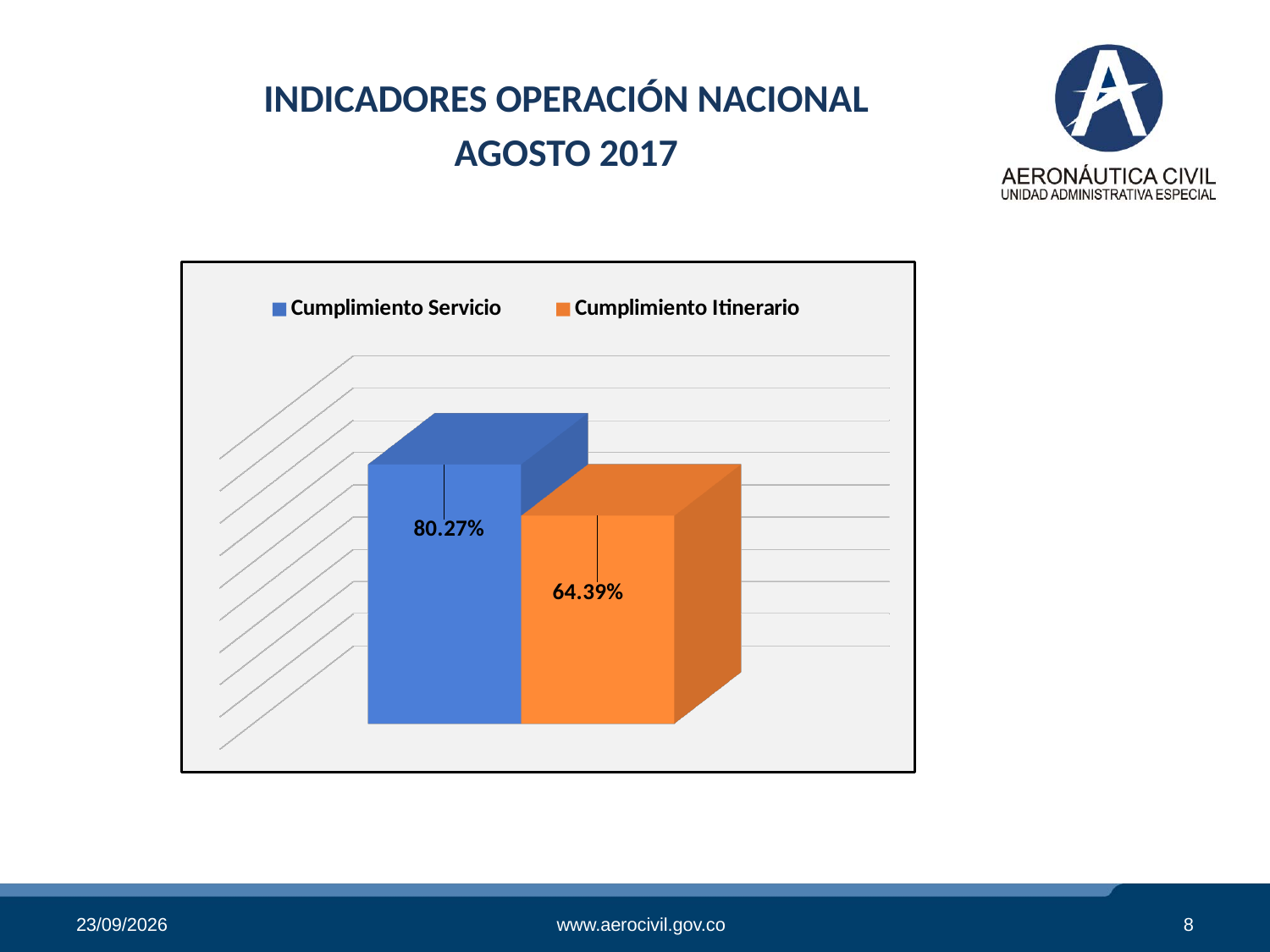
What is the difference between the Cumplimiento Servicio and Cumplimiento Itinerario values? 15.88% What is the value for Cumplimiento Servicio? 80.27% Which series has the higher value, Cumplimiento Servicio or Cumplimiento Itinerario? Cumplimiento Servicio Which series has the lowest value? Cumplimiento Itinerario How many series does the legend list? 2 How many bars are plotted in the chart? 2 What is the value for Cumplimiento Itinerario? 64.39% Which series has the highest value? Cumplimiento Servicio What kind of chart is shown on the slide? Bar chart What colour is the bar for Cumplimiento Itinerario? Orange What colour is the bar for Cumplimiento Servicio? Blue